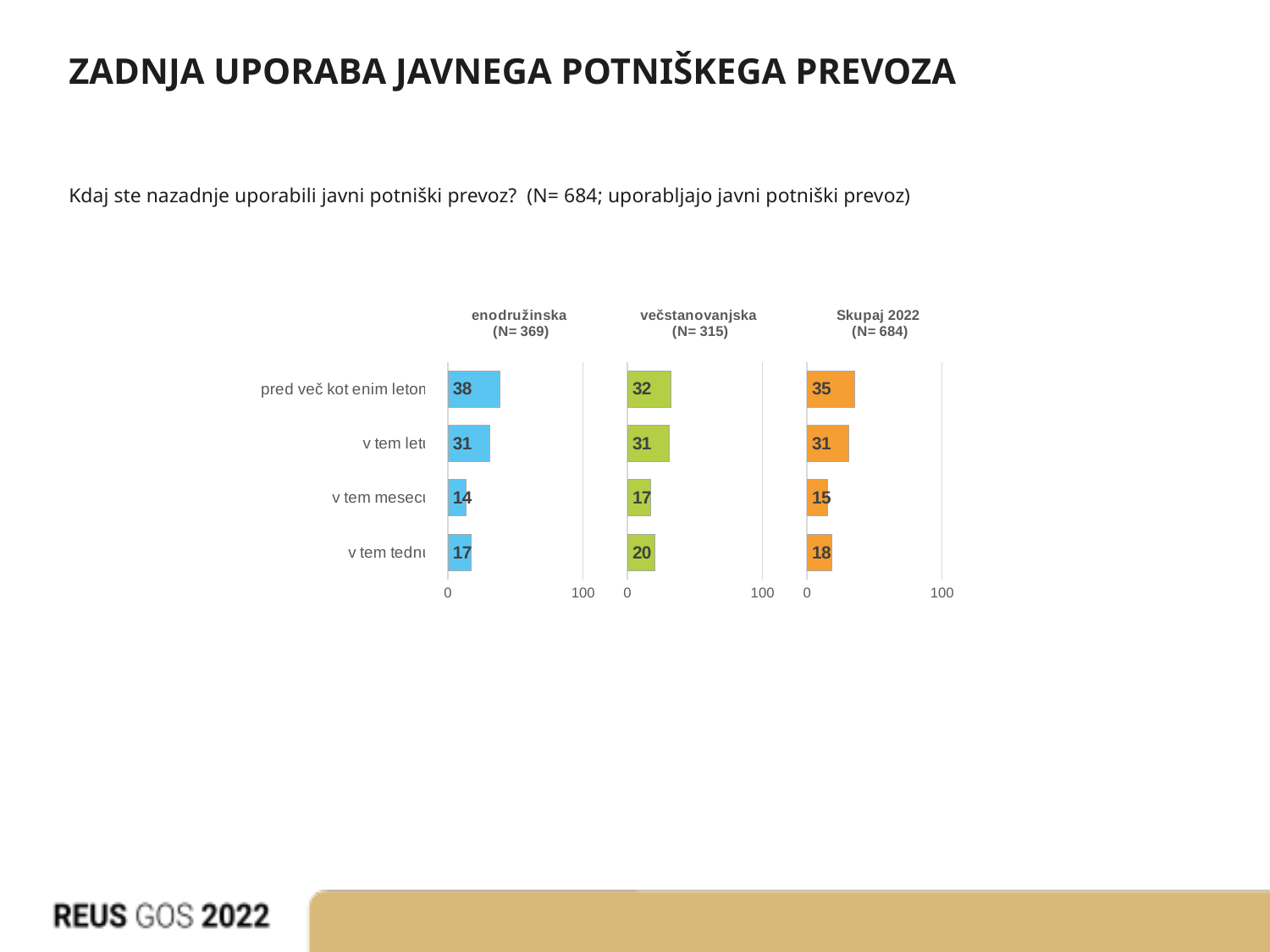
In the 'enodružinska (N= 369)' chart, which is larger: 'v tem tednu' or 'v tem mesecu'? v tem tednu In the 'večstanovanjska (N= 315)' chart, what is the value for 'v tem tednu'? 20 Is the value for 'pred več kot enim letom' in the 'Skupaj 2022 (N= 684)' chart greater or less than 100? less How many categories are shown in the 'Skupaj 2022 (N= 684)' chart? 4 In the 'enodružinska (N= 369)' chart, what is the value for 'pred več kot enim letom'? 38 In the 'enodružinska (N= 369)' chart, which category has the lowest value? v tem mesecu In the 'Skupaj 2022 (N= 684)' chart, what is the value for 'v tem mesecu'? 15 What kind of chart is the 'enodružinska (N= 369)' chart? bar chart What colour are the bars in the 'Skupaj 2022 (N= 684)' chart? orange In the 'Skupaj 2022 (N= 684)' chart, which category has the highest value? pred več kot enim letom How many separate charts are shown on the slide? 3 In the 'večstanovanjska (N= 315)' chart, what is the difference between 'pred več kot enim letom' and 'v tem mesecu'? 15